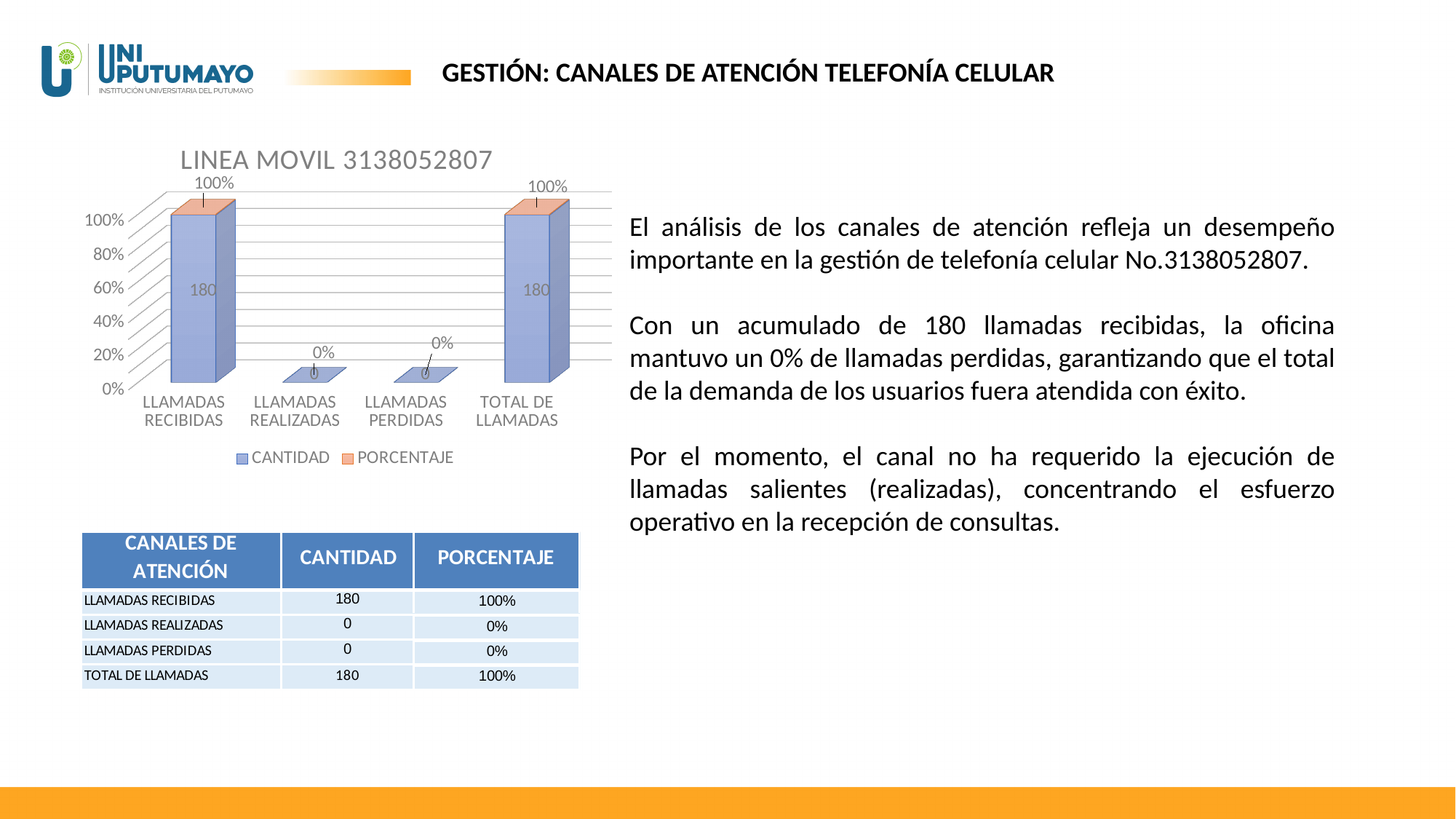
How many series does the chart legend list? 2 Which series are listed in the chart legend? CANTIDAD and PORCENTAJE What is the PORCENTAJE value for LLAMADAS RECIBIDAS? 100% What is the CANTIDAD value for LLAMADAS RECIBIDAS? 180 What is the CANTIDAD value for LLAMADAS REALIZADAS? 0 What is the CANTIDAD value for TOTAL DE LLAMADAS? 180 Which category has the lowest CANTIDAD value, LLAMADAS RECIBIDAS or LLAMADAS PERDIDAS? LLAMADAS PERDIDAS What is the title of the chart? LINEA MOVIL 3138052807 How many categories are shown on the x axis of the chart? 4 What is the PORCENTAJE value for LLAMADAS PERDIDAS? 0% What type of chart is shown on the slide? bar chart What is the difference between the CANTIDAD values for LLAMADAS RECIBIDAS and LLAMADAS REALIZADAS? 180